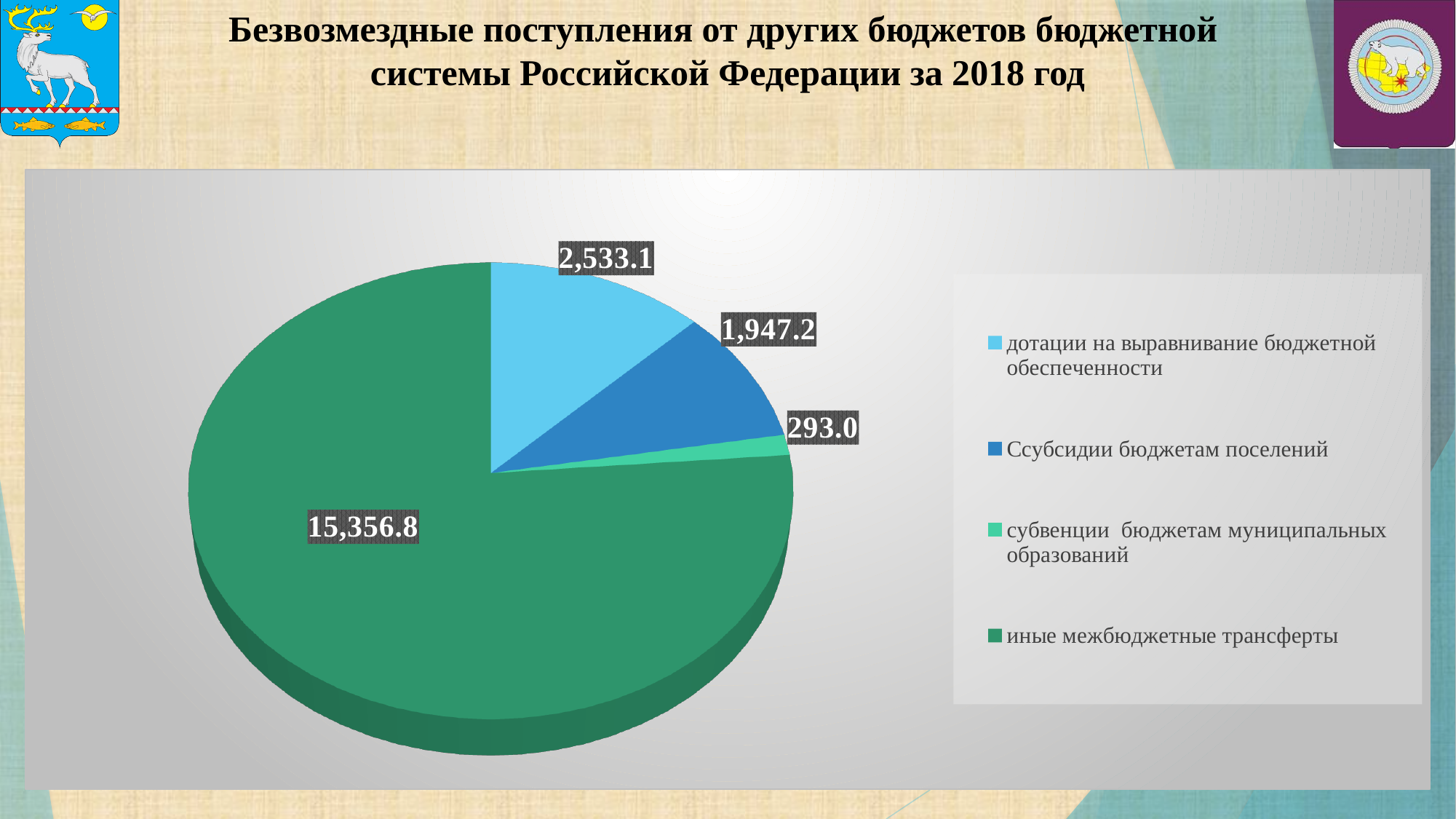
What is the value for "иные межбюджетные трансферты"? 15,356.8 What kind of chart is shown on the slide? pie chart What is the difference between the values for "дотации на выравнивание бюджетной обеспеченности" and "Ссубсидии бюджетам поселений"? 585.9 What is the value for "дотации на выравнивание бюджетной обеспеченности"? 2,533.1 What is the value for "субвенции бюджетам муниципальных образований"? 293.0 Which category has the smallest slice of the pie? субвенции бюджетам муниципальных образований What is the value for "Ссубсидии бюджетам поселений"? 1,947.2 What colour is the slice for "иные межбюджетные трансферты"? green How many slices does the pie chart have? 4 Which is larger: the value for "Ссубсидии бюджетам поселений" or the value for "субвенции бюджетам муниципальных образований"? Ссубсидии бюджетам поселений What is the difference between the values for "иные межбюджетные трансферты" and "дотации на выравнивание бюджетной обеспеченности"? 12,823.7 Which category has the largest slice of the pie? иные межбюджетные трансферты